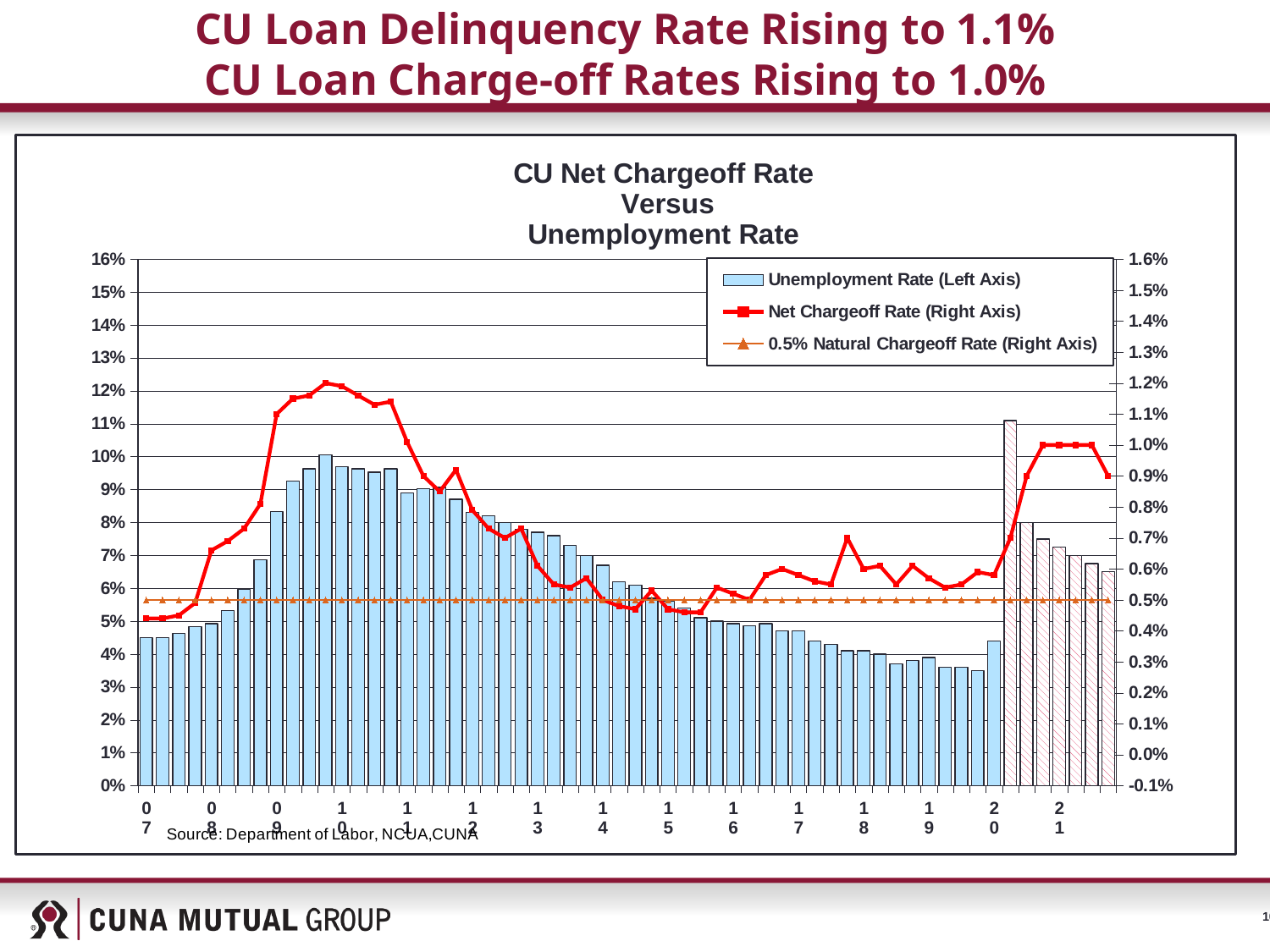
Which series is plotted on the left axis? Unemployment Rate In which year are the Unemployment Rate bars at their lowest level? 2019 What kind of chart is shown on the slide? A combination bar and line chart What is the title of the chart? CU Net Chargeoff Rate Versus Unemployment Rate Is the highest Unemployment Rate bar greater or less than 9%? greater How many series does the legend list? 3 Is the first Unemployment Rate bar in 2007 greater or less than 5%? less In which year do the Unemployment Rate bars reach their highest level? 2020 Does the Unemployment Rate rise or fall from 2010 to 2019? fall What value does the 0.5% Natural Chargeoff Rate line hold across the chart? 0.5% Is the peak of the Net Chargeoff Rate line greater or less than 1.1%? greater Which is larger, the Unemployment Rate in 2010 or in 2019? 2010